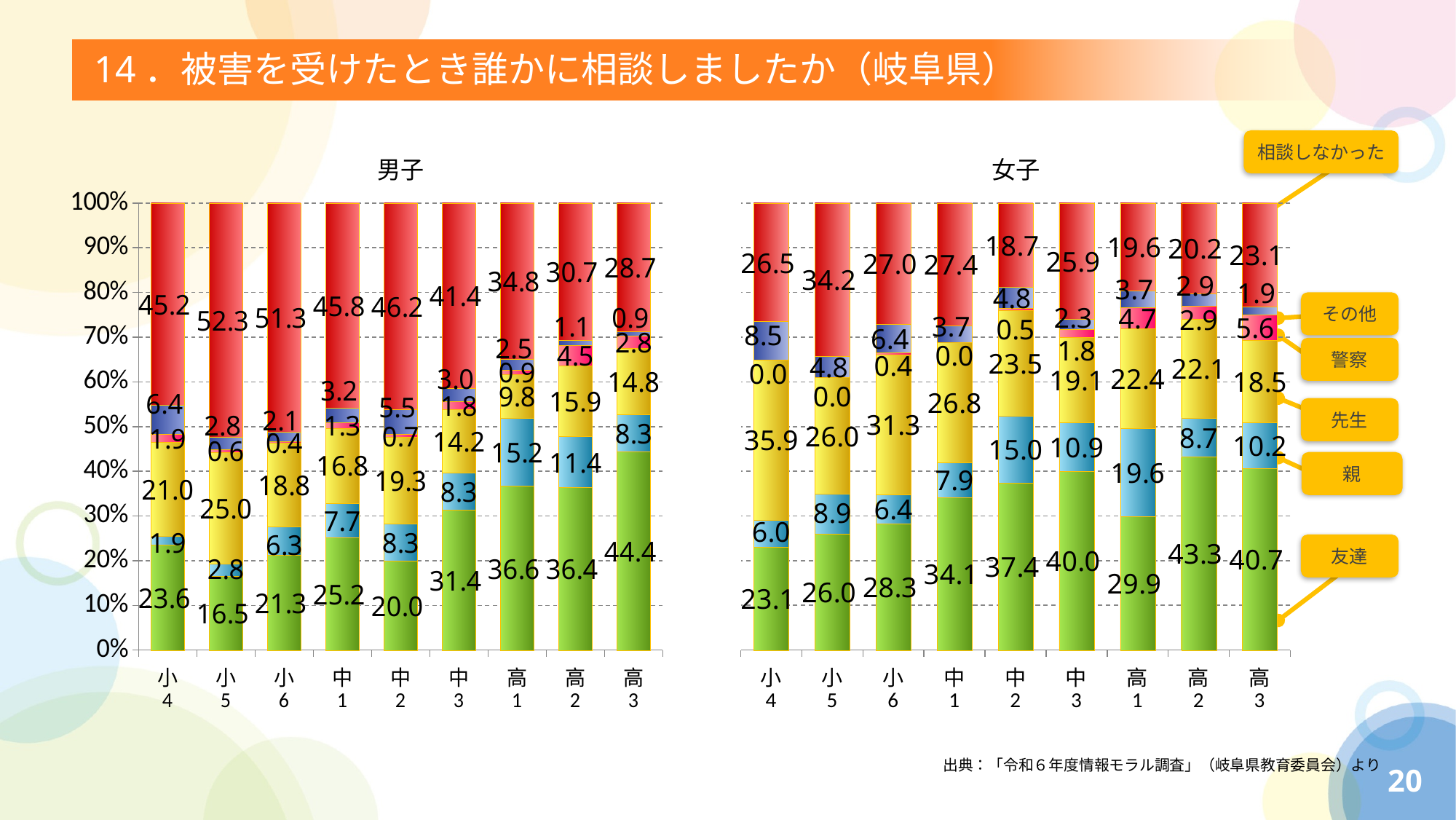
In the 男子 chart, which category has the highest value for 相談しなかった? 小5 How many categories are shown on the x axis of the 男子 chart? 9 In the 男子 chart, what is the difference between the 友達 values for 高3 and 小4? 20.8 How many series does the legend list? 6 What kind of chart is the 女子 chart? stacked bar chart In the 女子 chart, what is the value for 親 at 高1? 22.4 In the 男子 chart, what is the value for 相談しなかった at 小5? 52.3 In the 女子 chart, what is the value for 先生 at 小4? 6.0 Which series is shown in green in both charts? 友達 In the 男子 chart, what is the value for 友達 at 高3? 44.4 In the 女子 chart, which is larger, the 友達 value for 高2 or for 高3? 高2 In the 女子 chart, which category has the lowest value for 相談しなかった? 中2